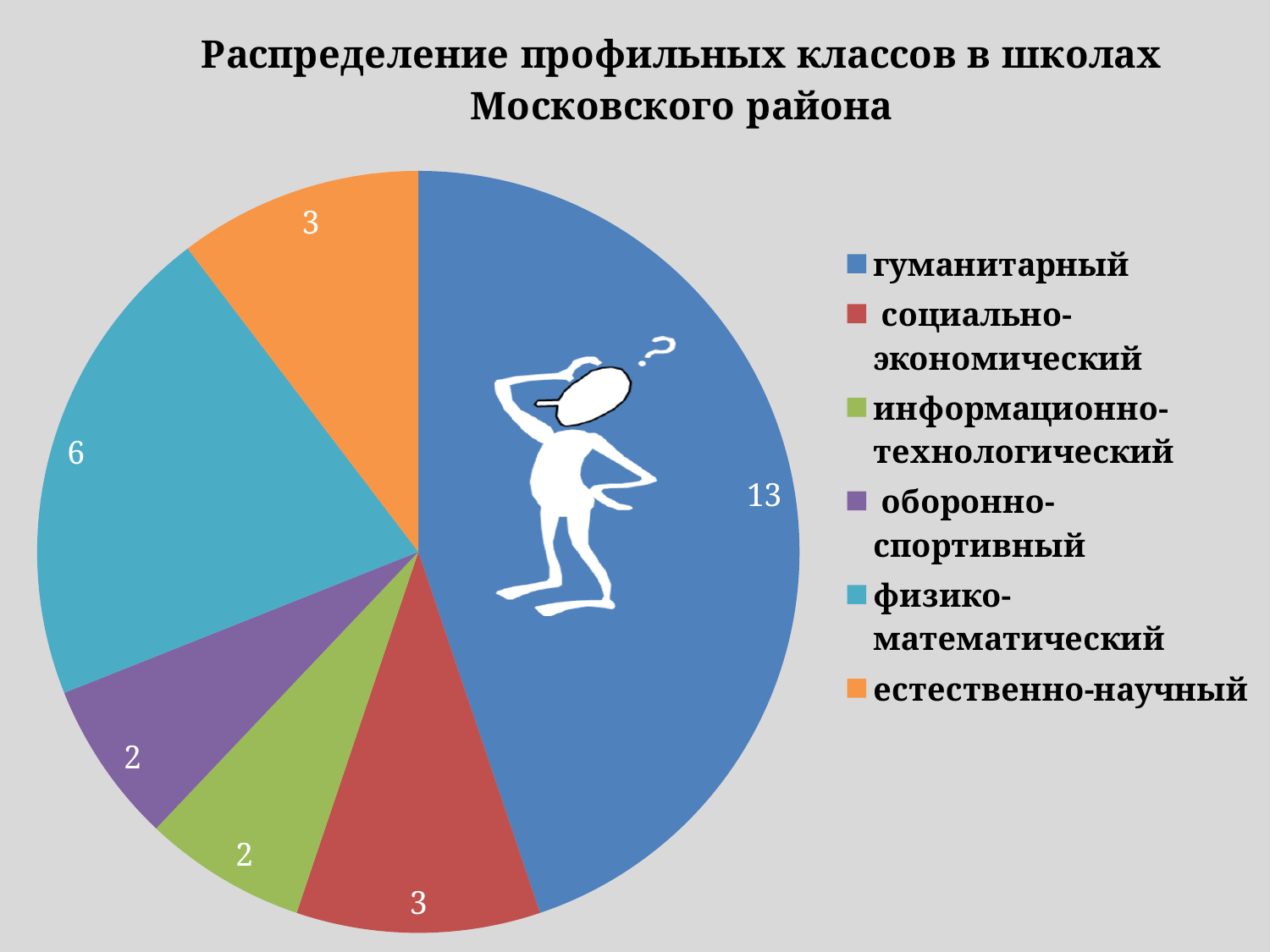
Which is larger, физико-математический or естественно-научный? физико-математический What is the value for оборонно-спортивный? 2 What is the value for социально-экономический? 3 What is the difference between the values for гуманитарный and физико-математический? 7 What type of chart is shown on the slide? pie chart Which categories have the smallest value? информационно-технологический and оборонно-спортивный What is the value for гуманитарный? 13 What is the title of the chart? Распределение профильных классов в школах Московского района What is the total of all slices in the pie chart? 29 What is the value for физико-математический? 6 Which category has the largest slice? гуманитарный How many categories does the pie chart have? 6